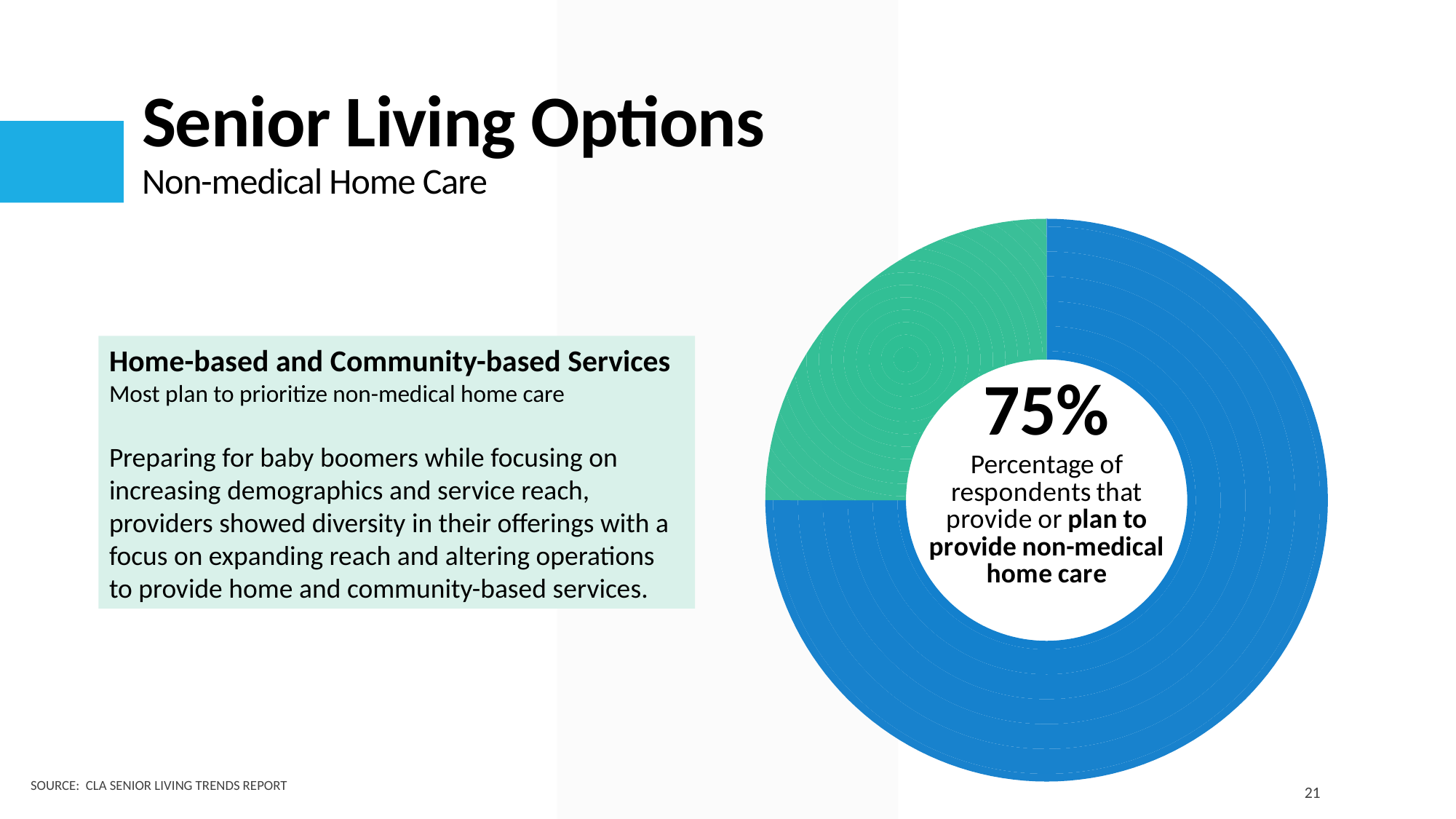
What is the title of the slide containing the donut chart? Senior Living Options Is the green segment of the donut chart greater or less than 50% of the whole? less How many segments does the donut chart have? 2 Which segment of the donut chart is larger, the blue one or the green one? the blue one What colour is the segment representing the 75% of respondents that provide or plan to provide non-medical home care? blue Which segment of the donut chart is the largest? the blue segment (respondents that provide or plan to provide non-medical home care) What kind of chart is shown on the slide? donut chart Is the blue segment of the donut chart greater or less than 50% of the whole? greater What percentage of respondents provide or plan to provide non-medical home care, according to the chart? 75%